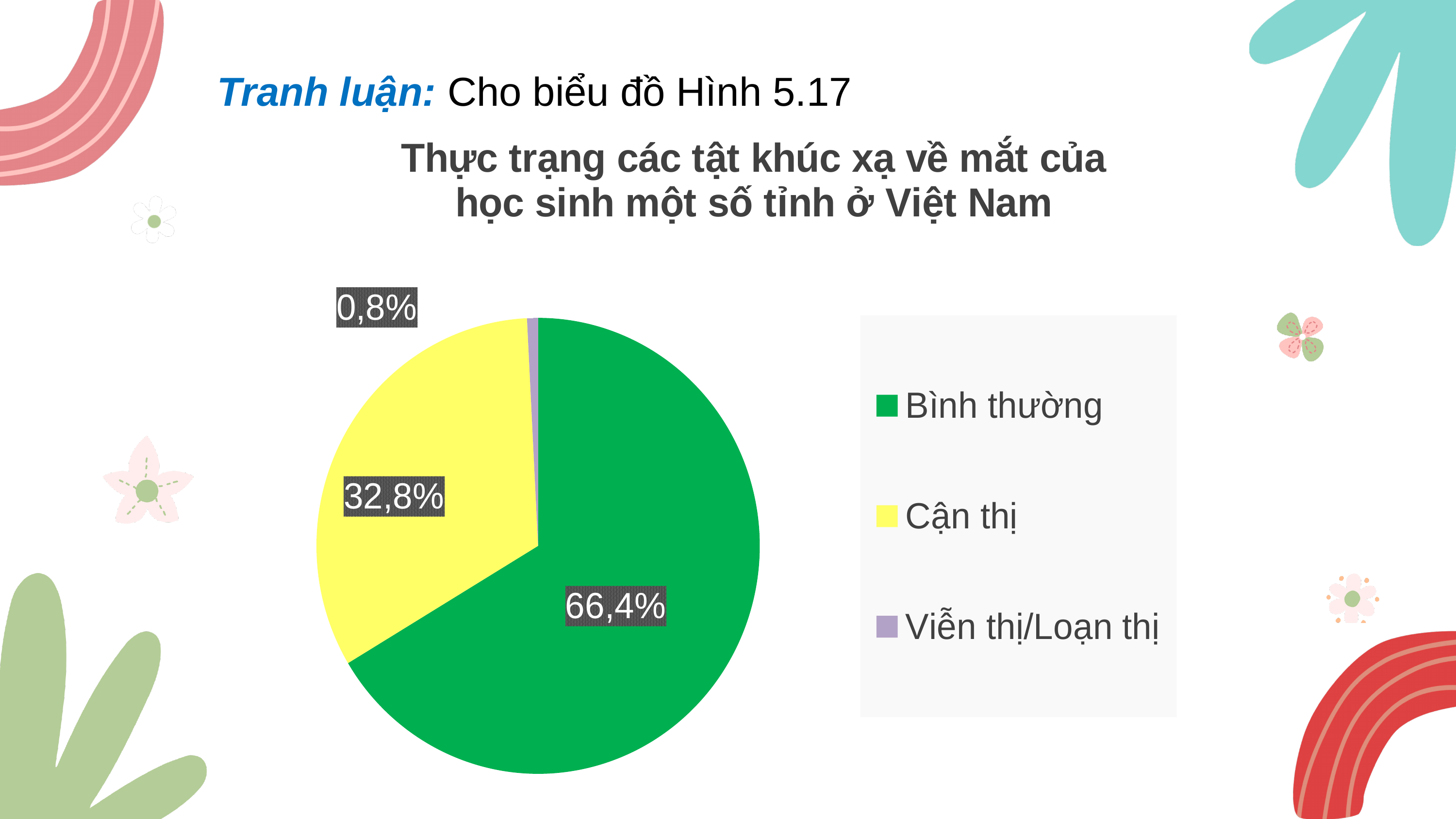
What percentage of the pie is labelled for Viễn thị/Loạn thị? 0,8% What percentage of the pie is labelled for Cận thị? 32,8% What percentage of the pie is labelled for Bình thường? 66,4% How many categories does the pie chart show? 3 What colour is the slice for Cận thị? Yellow What kind of chart is shown on the slide? Pie chart How many entries does the legend list? 3 Which category has the smallest slice of the pie? Viễn thị/Loạn thị What is the title of the chart? Thực trạng các tật khúc xạ về mắt của học sinh một số tỉnh ở Việt Nam What is the difference in percentage points between Bình thường and Cận thị? 33,6 Which is larger, the share for Cận thị or the share for Viễn thị/Loạn thị? Cận thị Which category has the largest slice of the pie? Bình thường